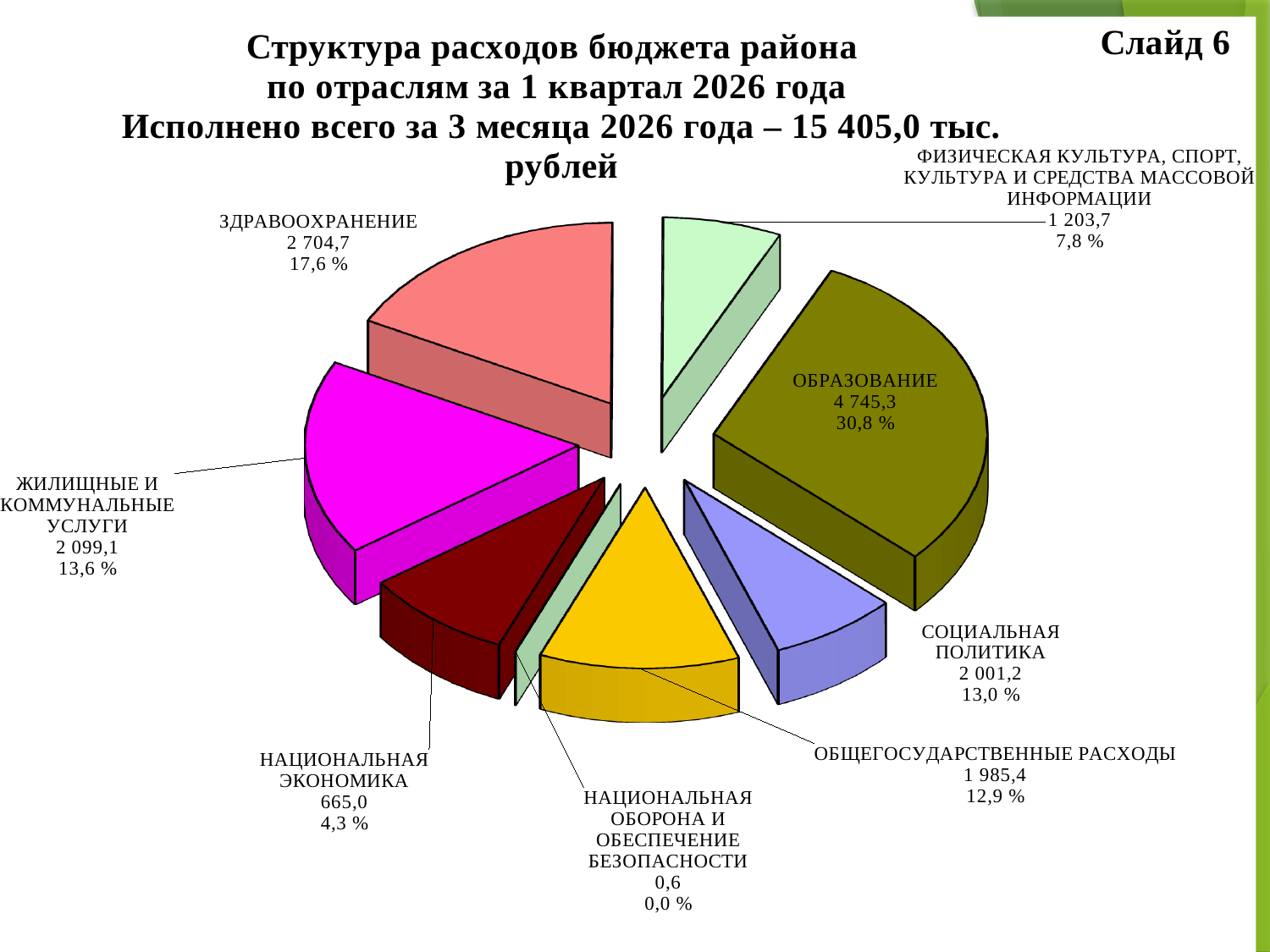
Какой тип диаграммы показан на слайде? Круговая диаграмма Какая доля в процентах указана для категории «ЗДРАВООХРАНЕНИЕ»? 17,6 % Какая категория имеет наибольшую долю расходов на диаграмме? ОБРАЗОВАНИЕ На сколько расходы на «ЗДРАВООХРАНЕНИЕ» больше расходов на «ЖИЛИЩНЫЕ И КОММУНАЛЬНЫЕ УСЛУГИ»? 605,6 Что больше: расходы на «СОЦИАЛЬНАЯ ПОЛИТИКА» или на «НАЦИОНАЛЬНАЯ ЭКОНОМИКА»? СОЦИАЛЬНАЯ ПОЛИТИКА Какая доля в процентах указана для категории «ОБЩЕГОСУДАРСТВЕННЫЕ РАСХОДЫ»? 12,9 % Какая категория имеет наименьшую долю расходов на диаграмме? НАЦИОНАЛЬНАЯ ОБОРОНА И ОБЕСПЕЧЕНИЕ БЕЗОПАСНОСТИ Какая общая сумма исполненных расходов за 3 месяца 2026 года указана в заголовке слайда? 15 405,0 тыс. рублей Какое значение указано для категории «ОБРАЗОВАНИЕ» на диаграмме? 4 745,3 Какое значение указано для категории «СОЦИАЛЬНАЯ ПОЛИТИКА»? 2 001,2 На сколько расходы на «ОБРАЗОВАНИЕ» больше расходов на «ЗДРАВООХРАНЕНИЕ»? 2 040,6 Сколько категорий (секторов) показано на диаграмме? 8